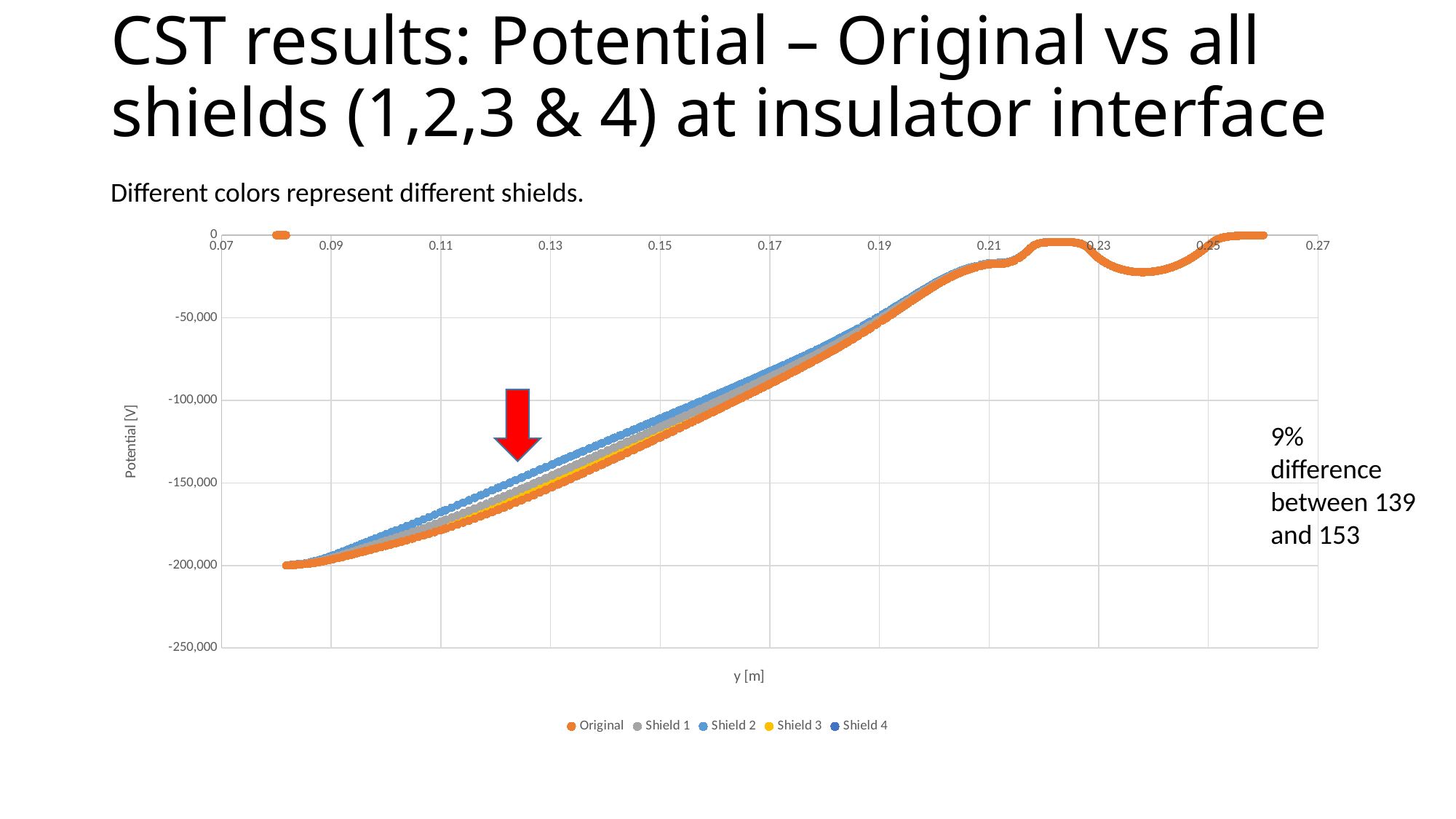
What is the label of the vertical axis? Potential [V] What kind of chart is shown on the slide? scatter chart Is the Original series value at y = 0.17 greater or less than -100,000? greater What is the lowest potential value reached by the curves, as read from the axis gridline they start on? -200,000 Which series has the highest (least negative) potential around y = 0.13? Shield 2 What are the series names listed in the legend? Original, Shield 1, Shield 2, Shield 3, Shield 4 How many series does the legend list? 5 Is the Original series value at y = 0.21 greater or less than -50,000? greater At y = 0.13, which series has the larger (less negative) potential, Shield 2 or Original? Shield 2 Which series has the lowest (most negative) potential around y = 0.13? Original Do the potential values rise or fall as y [m] increases from 0.09 to 0.21? rise Is the Original series value at y = 0.11 greater or less than -150,000? less